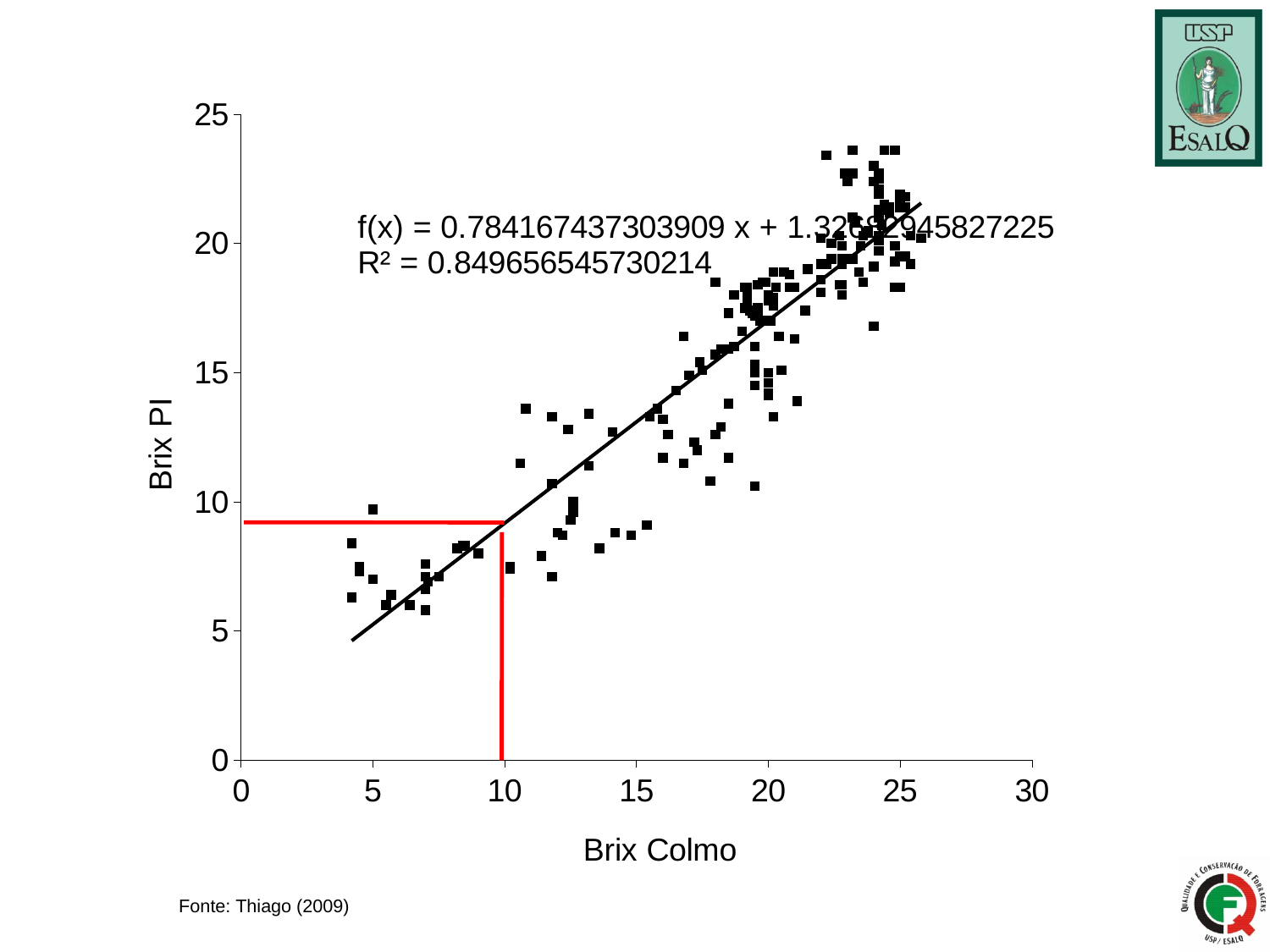
What is the R² value printed on the chart? 0.849656545730214 Do the Brix PI values generally rise or fall as Brix Colmo increases? rise What is the label of the x axis? Brix Colmo What is the slope (coefficient of x) in the fitted equation printed on the chart? 0.784167437303909 What is the highest tick value shown on the x axis? 30 Is the slope of the fitted line printed on the chart greater or less than 1? less Is the Brix PI value where the red horizontal line meets the y axis greater or less than 10? less Is the R² value printed on the chart greater or less than 0.8? greater What is the highest tick value shown on the y axis? 25 What is the label of the y axis? Brix PI What kind of chart is shown on the slide? scatter plot